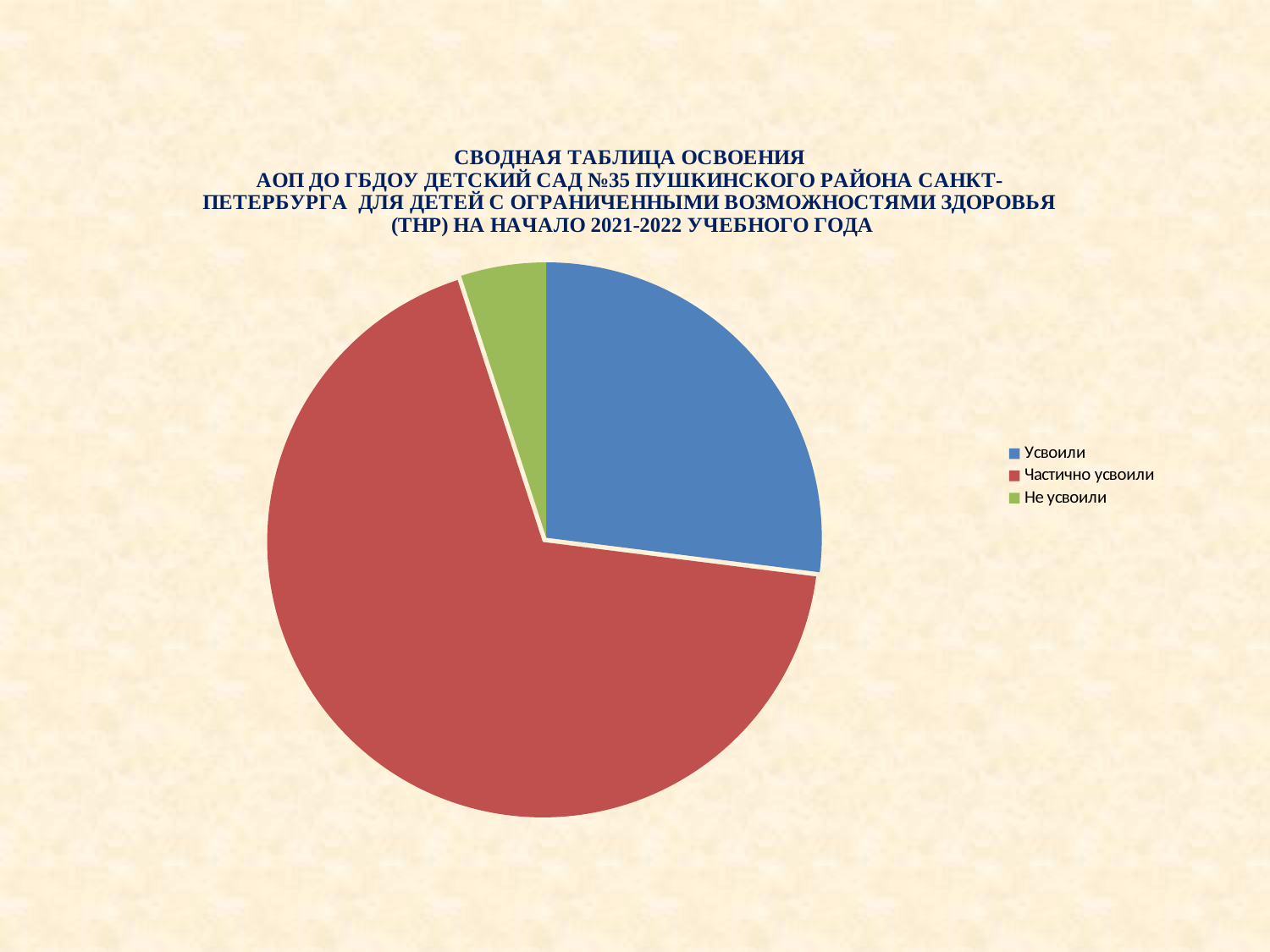
Which category has the largest slice of the pie chart? Частично усвоили Which slice is larger in the pie chart, Частично усвоили or Усвоили? Частично усвоили Which slice is smaller in the pie chart, Частично усвоили or Не усвоили? Не усвоили Which category has the smallest slice of the pie chart? Не усвоили Which slice is larger in the pie chart, Усвоили or Не усвоили? Усвоили How many entries does the legend of the pie chart list? 3 Which category is shown in green in the pie chart? Не усвоили What kind of chart is shown on the slide? pie chart How many slices does the pie chart have? 3 Which colour represents the category Частично усвоили in the pie chart? red